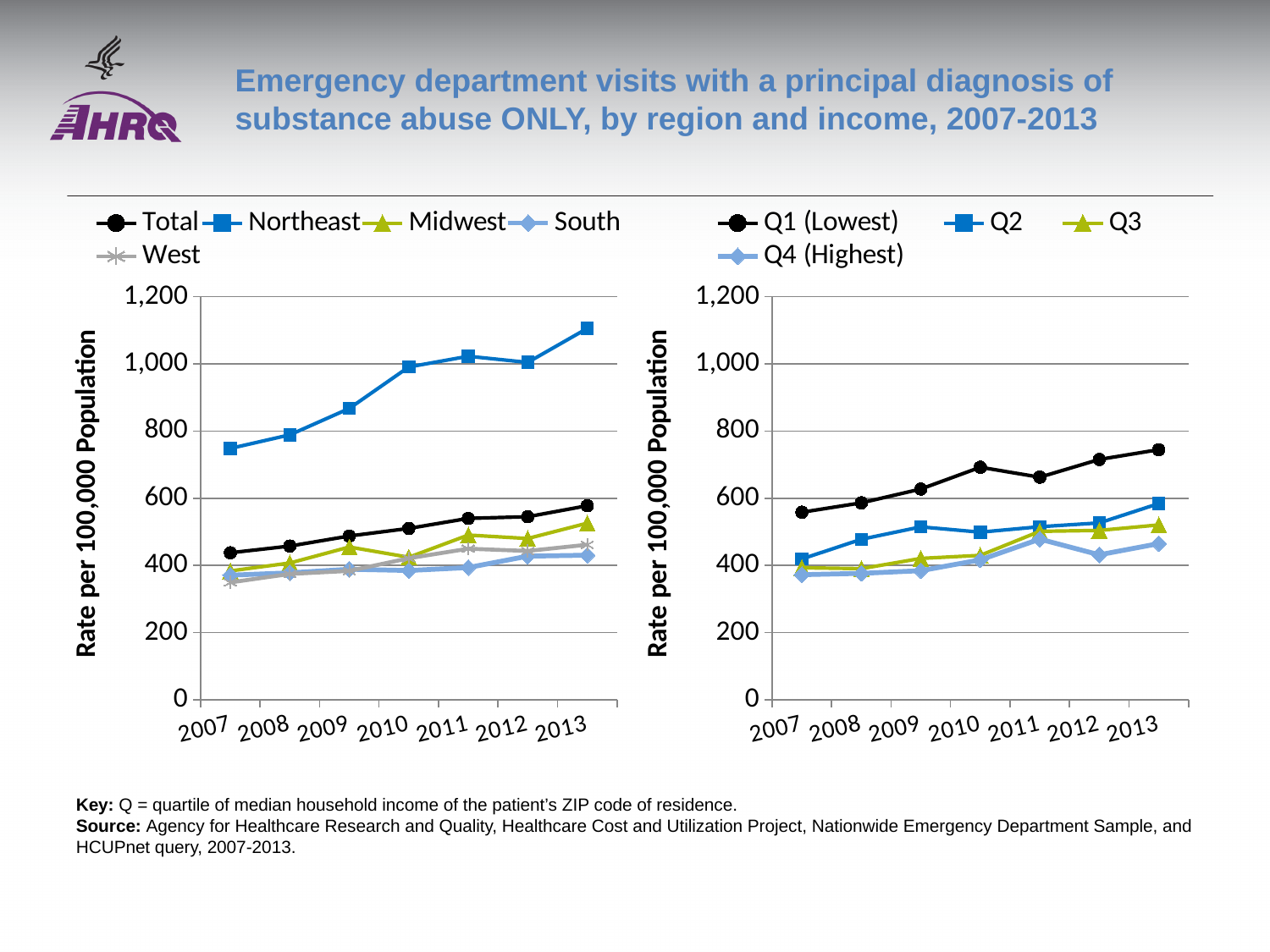
What kind of chart is the left chart (by region)? line chart In the left chart (by region), does the Northeast rate rise or fall from 2007 to 2013? rise In the right chart (by income quartile), is the value for Q1 (Lowest) in 2013 greater or less than 800? less In the left chart (by region), which region has the highest rate in 2013? Northeast In the right chart (by income quartile), which is larger in 2013, Q1 (Lowest) or Q4 (Highest)? Q1 (Lowest) In the left chart (by region), is the value for Northeast in 2013 greater or less than 1,000? greater In the right chart (by income quartile), which quartile has the highest rate in 2013? Q1 (Lowest) How many years are plotted along the x axis of the right chart (by income quartile)? 7 How many series does the legend of the left chart (by region) list? 5 In the right chart (by income quartile), is the value for Q4 (Highest) in 2007 greater or less than 400? less How many series does the legend of the right chart (by income quartile) list? 4